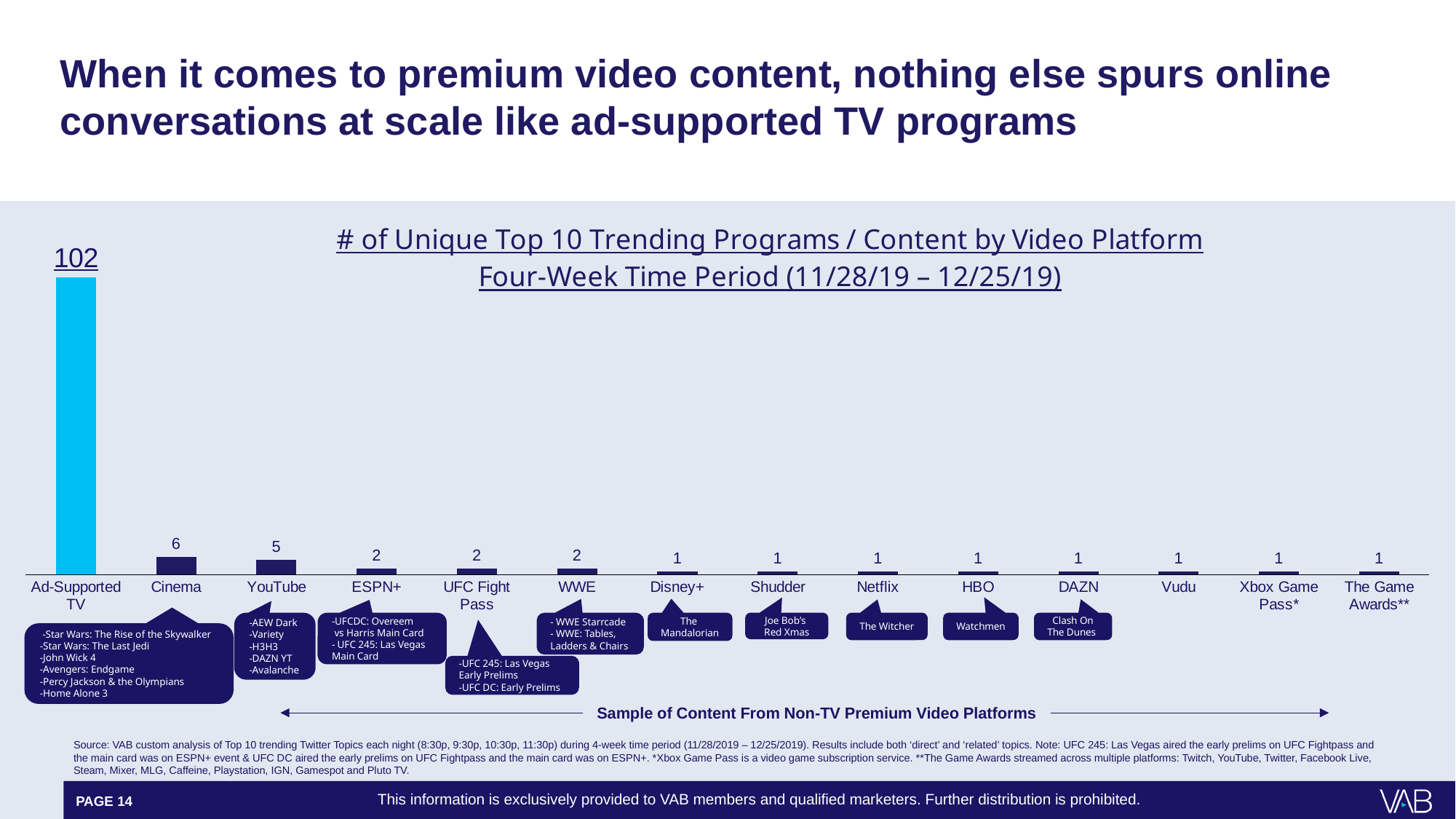
What is the value for Netflix? 1 What is the value for Cinema? 6 How many categories are shown on the x axis? 14 What is the difference between the values for Ad-Supported TV and Cinema? 96 Which is larger, the value for YouTube or the value for ESPN+? YouTube What time period does the chart title say the data covers? 11/28/19 – 12/25/19 What kind of chart is this? Bar chart What is the value for YouTube? 5 What is the difference between the values for Cinema and YouTube? 1 Which category has the highest value? Ad-Supported TV Do the values rise or fall moving from left to right along the x axis? Fall What is the value for Ad-Supported TV? 102